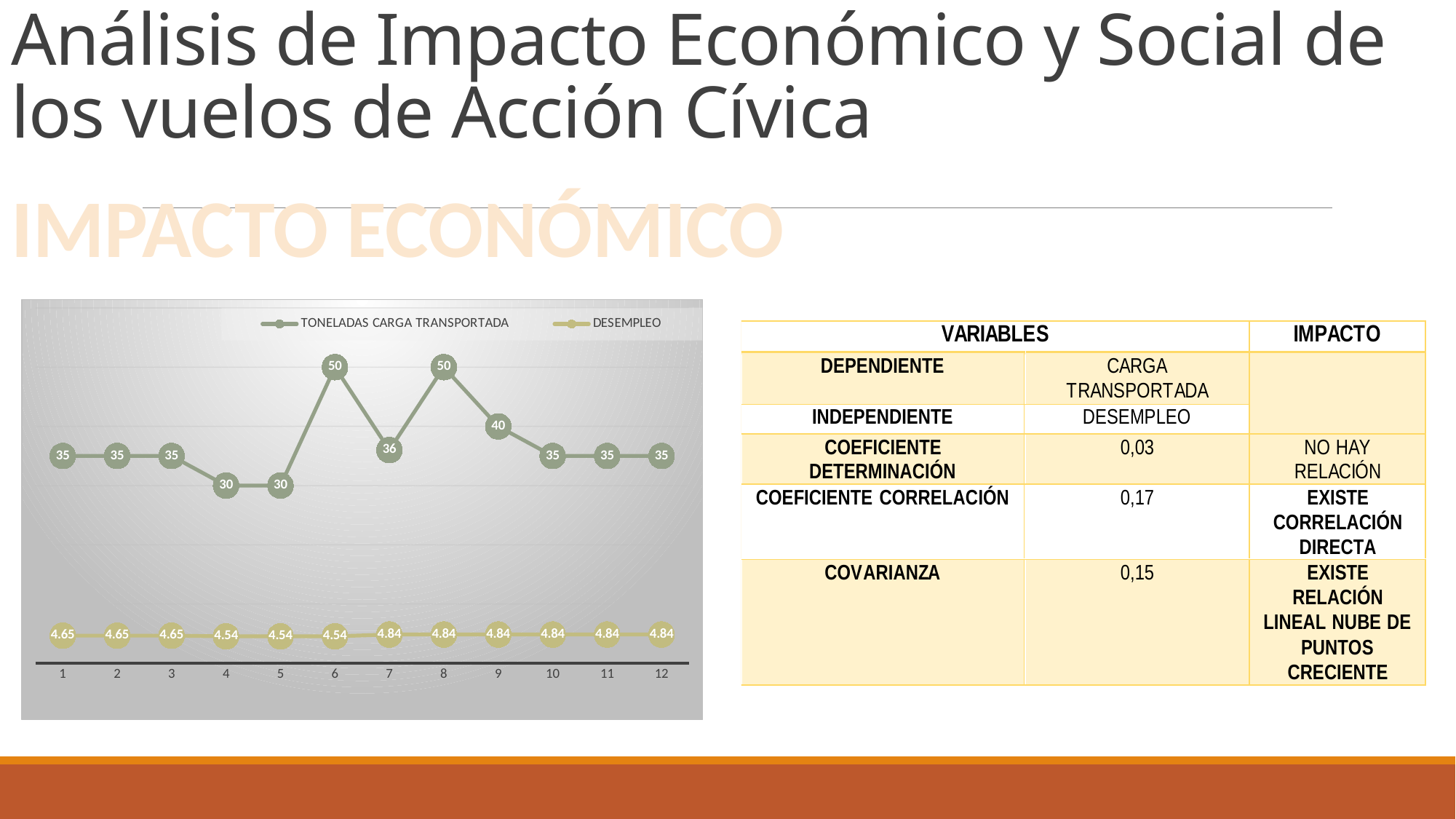
Which is larger: TONELADAS CARGA TRANSPORTADA at point 9 or at point 10? Point 9 What is the value of DESEMPLEO at point 12? 4.84 What is the value of TONELADAS CARGA TRANSPORTADA at point 9? 40 What is the name of the first series listed in the chart legend? TONELADAS CARGA TRANSPORTADA What is the value of TONELADAS CARGA TRANSPORTADA at point 6? 50 How many series does the chart legend list? 2 What is the difference between the TONELADAS CARGA TRANSPORTADA values at point 8 and point 7? 14 How many points are plotted along the x axis for each series? 12 What is the lowest value of TONELADAS CARGA TRANSPORTADA shown on the chart? 30 What type of chart is shown on the slide? Line chart What is the value of DESEMPLEO at point 1? 4.65 Does the DESEMPLEO series rise or fall from point 6 to point 7? Rise